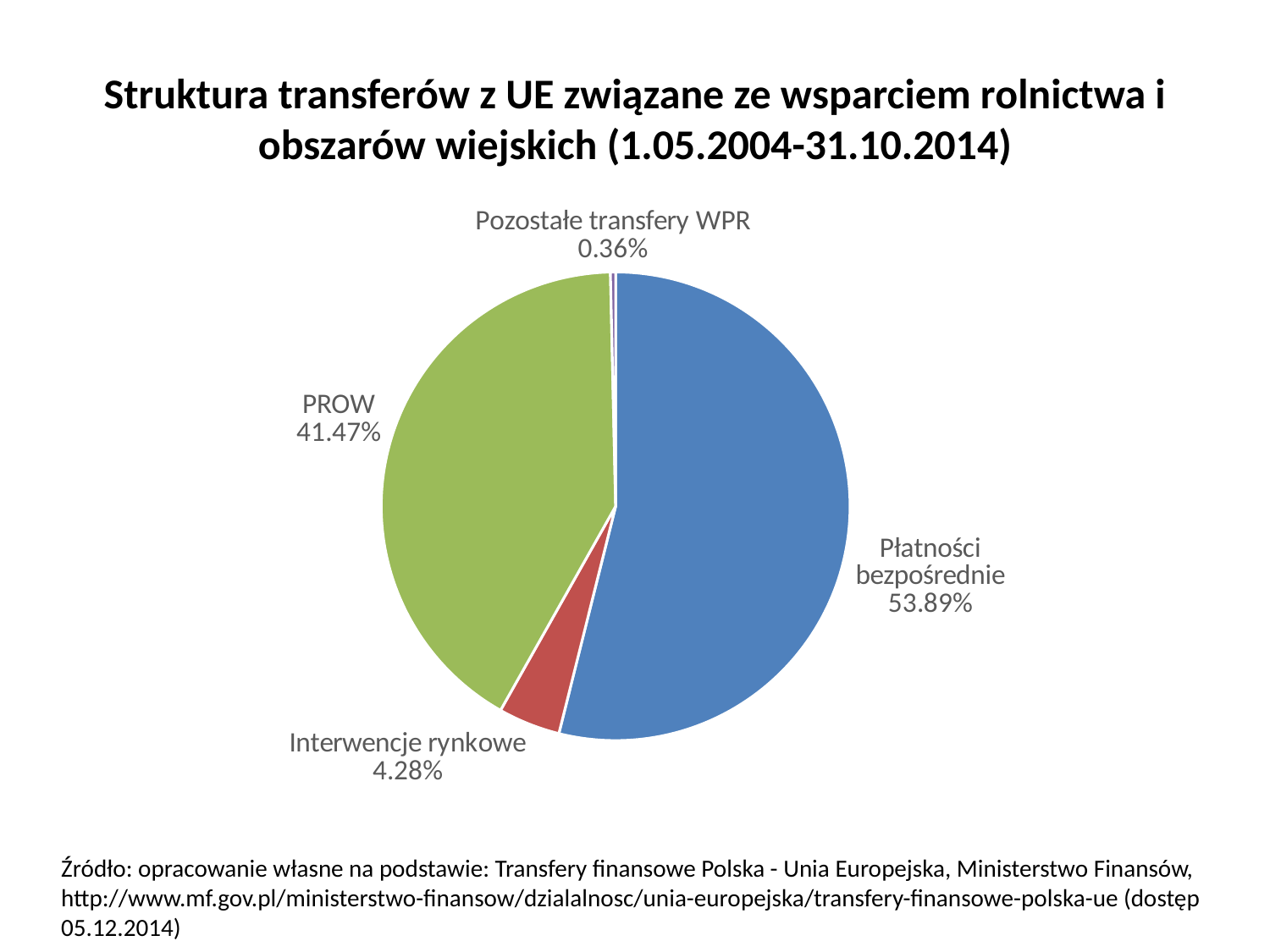
What kind of chart is shown on the slide? Pie chart Which category has the smallest slice of the pie? Pozostałe transfery WPR Which category has the largest slice of the pie? Płatności bezpośrednie What share of the pie does Płatności bezpośrednie have? 53.89% What is the difference between the shares of Płatności bezpośrednie and PROW? 12.42% Which is larger, the share of PROW or the share of Interwencje rynkowe? PROW How many categories are shown in the pie chart? 4 What is the difference between the shares of Interwencje rynkowe and Pozostałe transfery WPR? 3.92% What is the value shown for Interwencje rynkowe? 4.28% What share of the pie does PROW have? 41.47% What colour is the slice for PROW? Green What is the value shown for Pozostałe transfery WPR? 0.36%